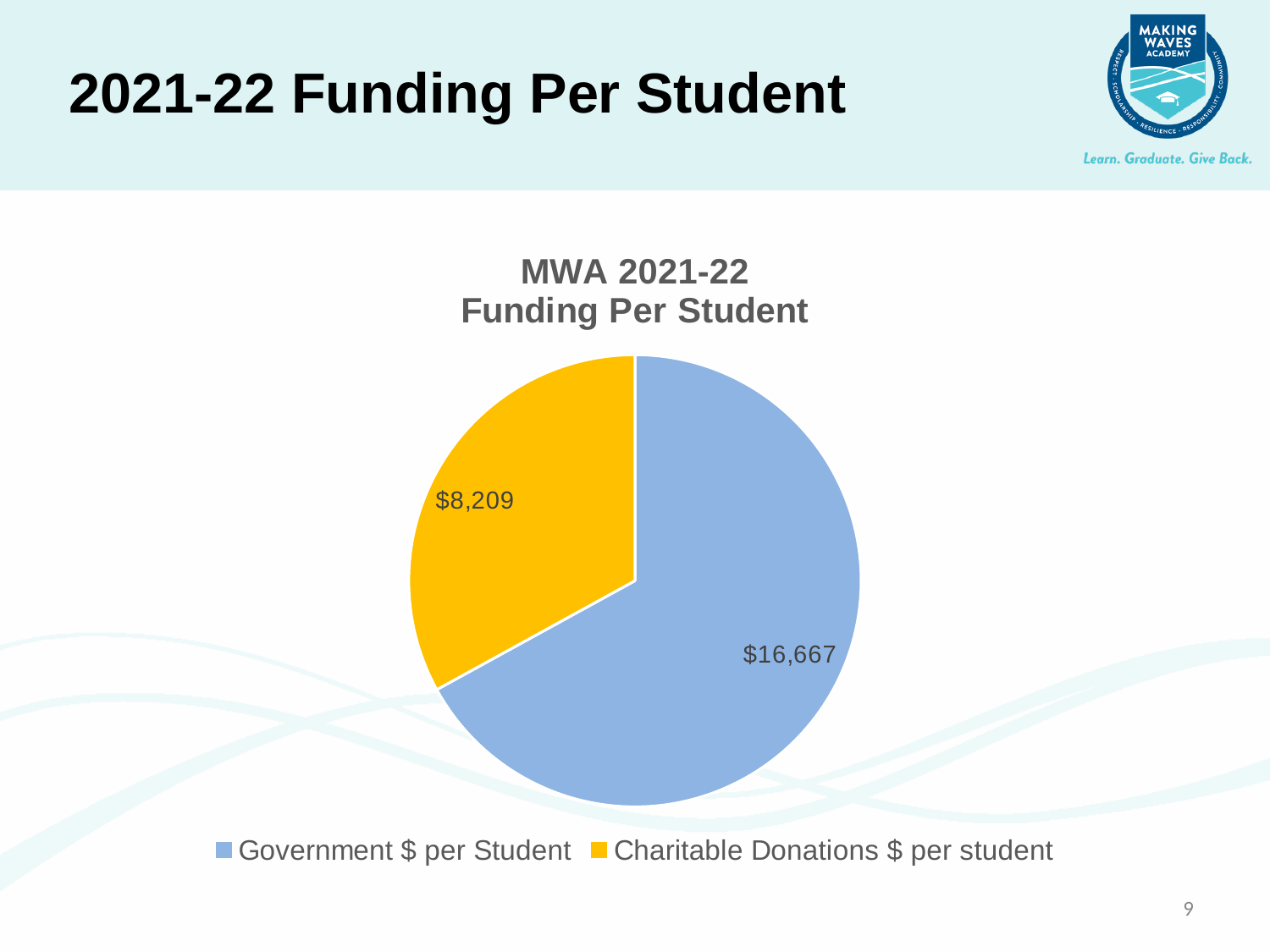
What is the total funding per student across both slices of the pie chart? $24,876 What is the title of the chart? MWA 2021-22 Funding Per Student How many slices does the pie chart have? 2 Which slice of the pie chart is the largest? Government $ per Student What kind of chart is shown on the slide? Pie chart What is the Government $ per Student value shown on the pie chart? $16,667 Which slice of the pie chart is the smallest? Charitable Donations $ per student How many entries does the chart legend list? 2 What share of the total funding per student does the Government $ per Student slice represent? 67% Which is larger, Government $ per Student or Charitable Donations $ per student? Government $ per Student What is the difference between the Government $ per Student and the Charitable Donations $ per student values? $8,458 What is the Charitable Donations $ per student value shown on the pie chart? $8,209